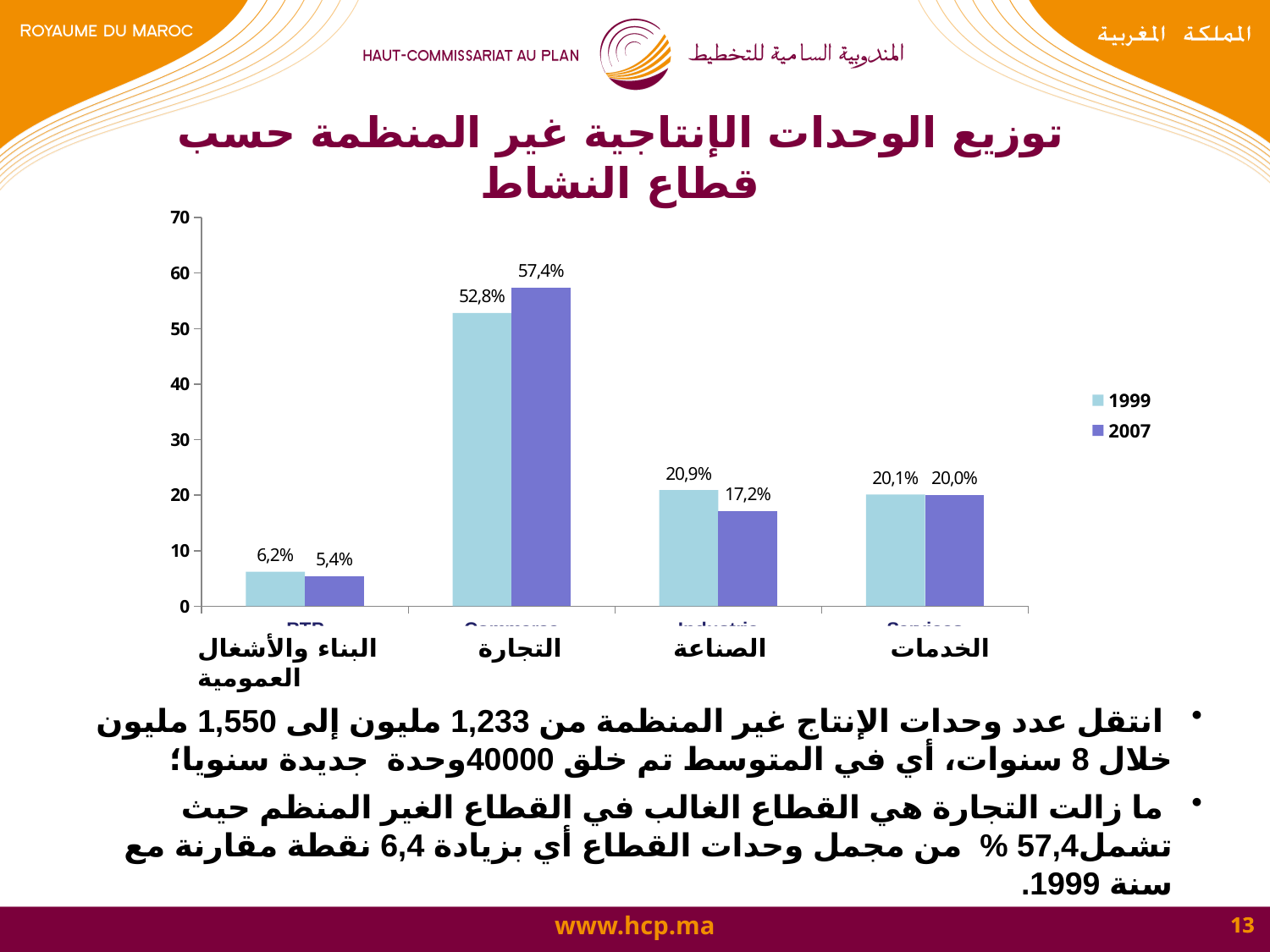
Which is larger for الصناعة (Industrie): the 1999 value or the 2007 value? 1999 What is the difference between the 2007 and 1999 values for التجارة (Commerce)? 4,6 percentage points Which two years are listed in the chart legend? 1999 and 2007 What is the value for البناء والأشغال العمومية (BTP) in 2007? 5,4% What type of chart is shown on the slide? bar chart What is the value for الصناعة (Industrie) in 1999? 20,9% Is the 1999 value for التجارة (Commerce) greater or less than 50? greater Which category has the highest value in 1999? التجارة (Commerce) How many series does the legend list? 2 How many categories are shown on the x axis of the chart? 4 Which category has the lowest value in 2007? البناء والأشغال العمومية (BTP) What is the value for التجارة (Commerce) in 2007? 57,4%